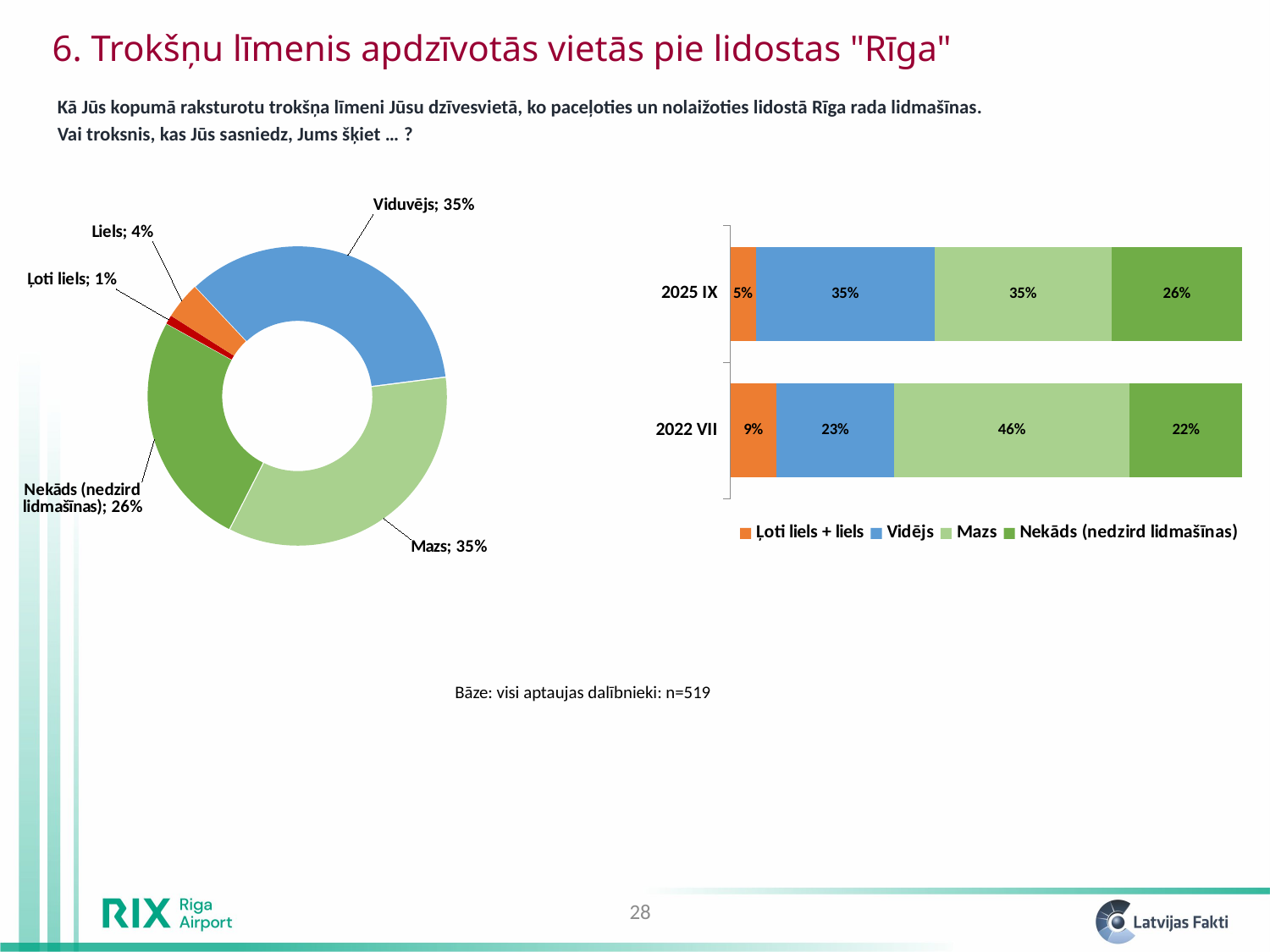
In the stacked bar chart on the right, which is larger: "Vidējs" in 2025 IX or "Vidējs" in 2022 VII? 2025 IX In the doughnut chart on the left, what is the value for "Nekāds (nedzird lidmašīnas)"? 26% In the doughnut chart on the left, which category has the lowest value? Ļoti liels In the doughnut chart on the left, what is the value for "Ļoti liels"? 1% In the stacked bar chart on the right, what is the difference between "Mazs" in 2022 VII and "Mazs" in 2025 IX? 11% In the doughnut chart on the left, what is the difference between "Viduvējs" and "Liels"? 31% What type of chart is shown on the right side of the slide? Stacked bar chart In the stacked bar chart on the right, how many series does the legend list? 4 In the stacked bar chart on the right, what is the value for "Mazs" in 2022 VII? 46% In the doughnut chart on the left, how many categories are shown? 5 In the stacked bar chart on the right, what is the value for "Ļoti liels + liels" in 2025 IX? 5% In the doughnut chart on the left, what is the value for "Mazs"? 35%